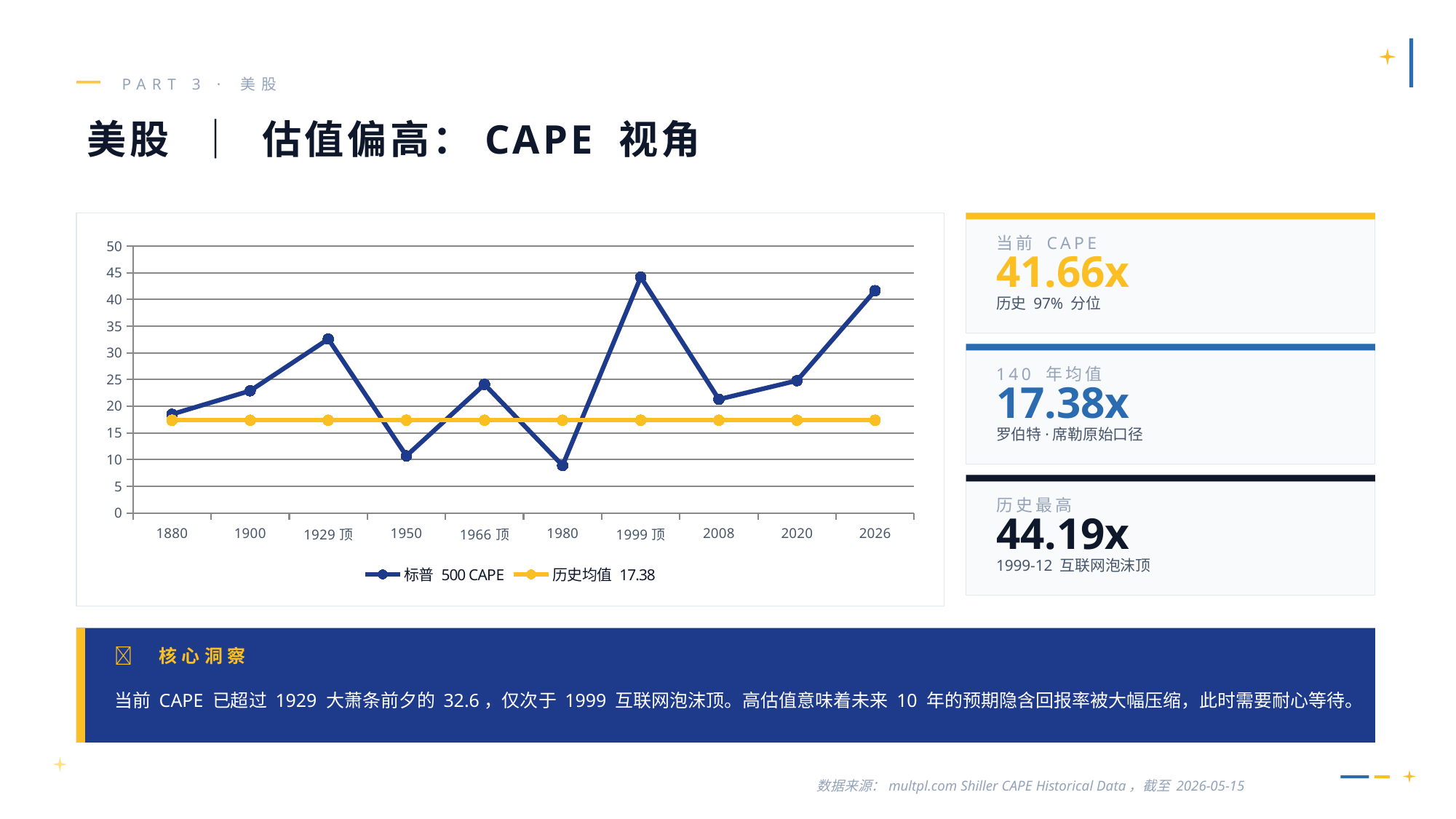
At which x-axis point does the 标普 500 CAPE series reach its highest value? 1999 顶 Does the 标普 500 CAPE series rise or fall from 2008 to 2026? rise How many points are plotted along the x axis of the chart? 10 Is the 标普 500 CAPE value at 2020 greater or less than 20? greater What is the name of the blue series in the chart legend? 标普 500 CAPE Is the 标普 500 CAPE value at 1950 greater or less than 15? less Is the 标普 500 CAPE value at 1929 顶 greater or less than 30? greater Which series is drawn in yellow on the chart? 历史均值 17.38 What value does the legend give for the 历史均值 series? 17.38 Which is larger, the 标普 500 CAPE value at 1929 顶 or at 2008? 1929 顶 What kind of chart is shown on the slide? line chart How many series does the chart legend list? 2